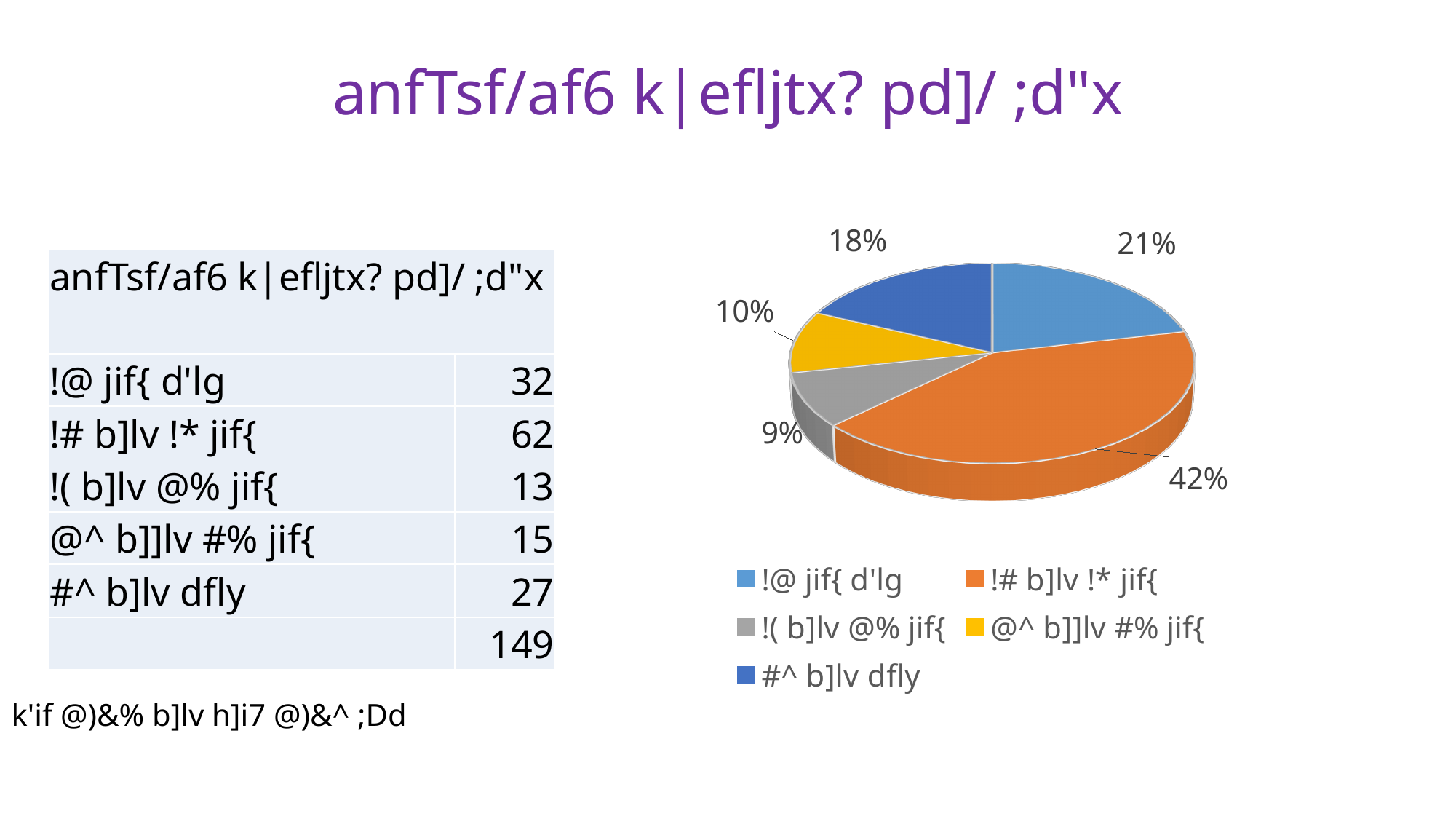
Which category has the smallest slice of the pie? !( b]lv @% jif{ What share of the pie does the slice for "!@ jif{ d'lg" represent? 21% What colour is the slice for "@^ b]]lv #% jif{" in the pie chart? yellow Which slice is larger: "!@ jif{ d'lg" or "#^ b]lv dfly"? !@ jif{ d'lg How many slices does the pie chart have? 5 What share of the pie does the slice for "@^ b]]lv #% jif{" represent? 10% How many entries does the pie chart's legend list? 5 What share of the pie does the slice for "#^ b]lv dfly" represent? 18% What is the difference in percentage points between the "!# b]lv !* jif{" slice and the "!@ jif{ d'lg" slice? 21% Which category has the largest slice of the pie? !# b]lv !* jif{ What kind of chart is shown on the slide? pie chart